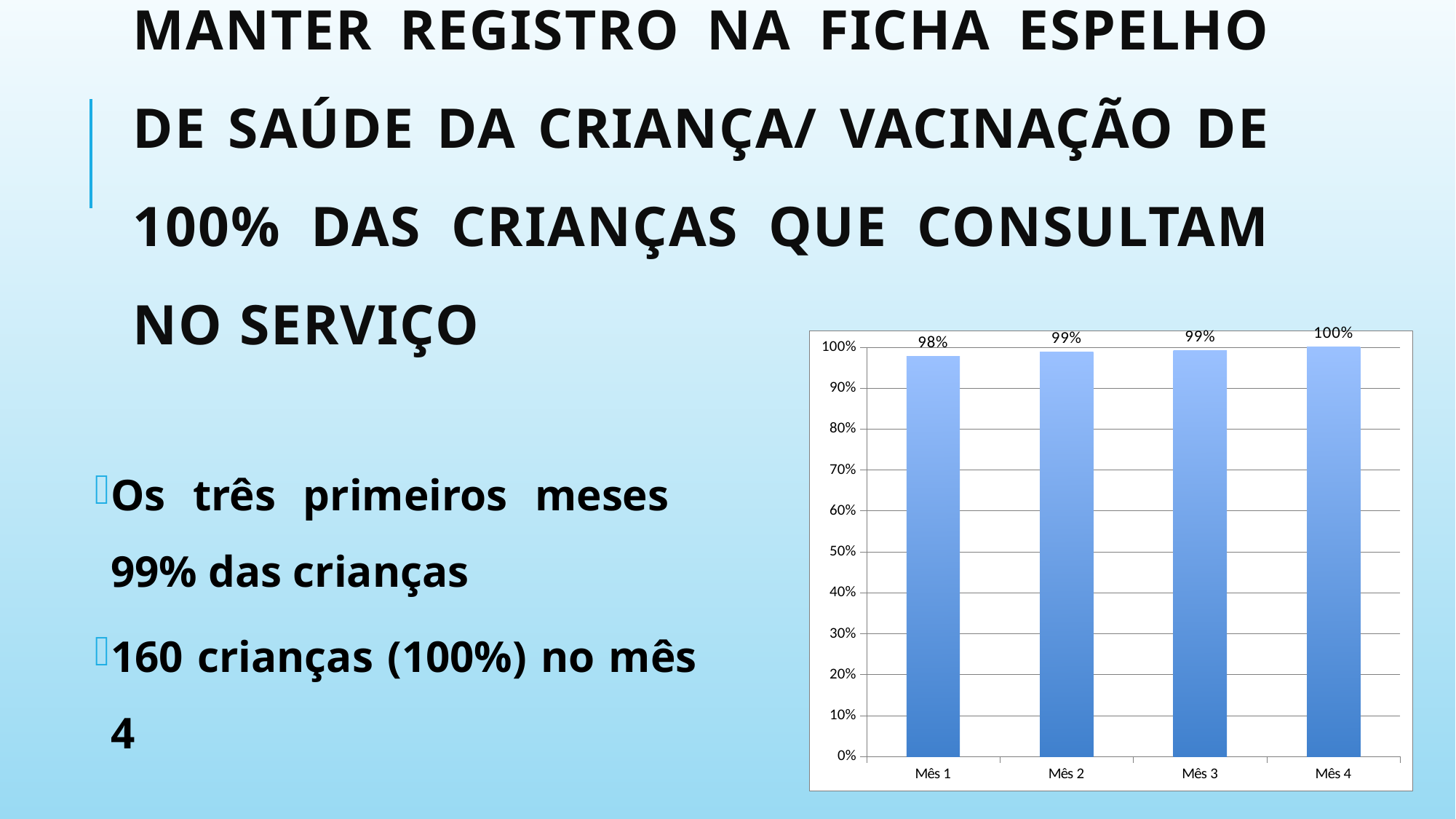
What is the value for Mês 2? 99% What is the difference between the values for Mês 4 and Mês 1? 2% What is the label of the last category on the x axis? Mês 4 Which is larger, the value for Mês 1 or the value for Mês 4? Mês 4 Is the value for Mês 3 greater or less than 90%? greater How many months are shown on the x axis? 4 What is the value for Mês 1? 98% Which month has the highest value? Mês 4 Do the values rise or fall from Mês 1 to Mês 4? rise What is the value for Mês 4? 100% Which month has the lowest value? Mês 1 What kind of chart is shown on the slide? bar chart